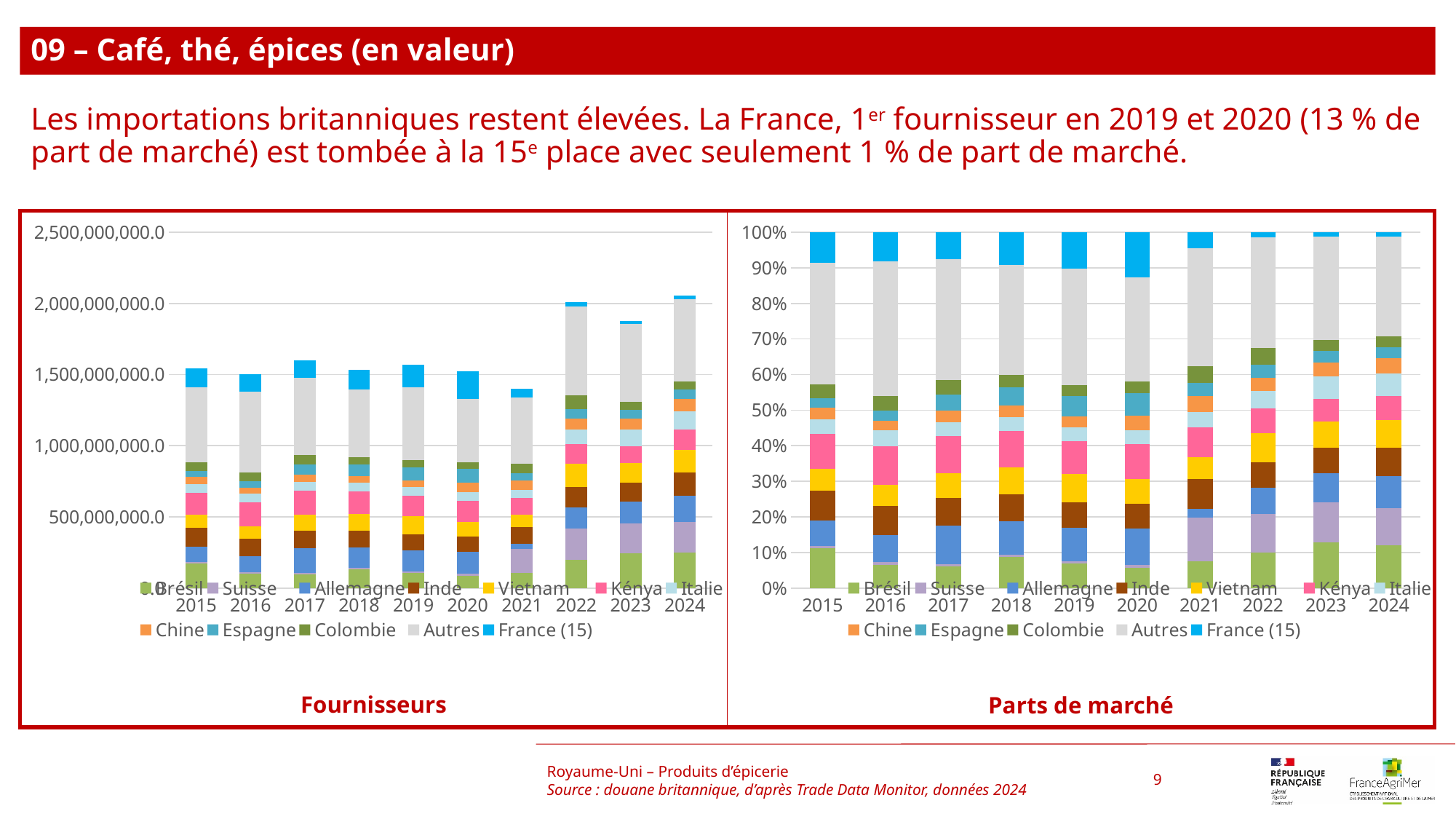
What kind of chart is the 'Parts de marché' chart on the right? 100% stacked bar chart In the 'Fournisseurs' chart, is the total for 2019 greater or less than 1,500,000,000.0? greater What is the last entry in the legend of the 'Fournisseurs' chart? France (15) In the 'Parts de marché' chart, is the share of Autres in 2015 greater or less than 30%? greater In the 'Fournisseurs' chart, which year has the lowest total bar? 2021 What kind of chart is the 'Fournisseurs' chart on the left? stacked bar chart In the 'Fournisseurs' chart, is the total for 2021 greater or less than 1,500,000,000.0? less In the 'Parts de marché' chart, how many series does the legend list? 12 In the 'Fournisseurs' chart, does the total rise or fall from 2021 to 2022? rise In the 'Fournisseurs' chart, how many years are shown on the x axis? 10